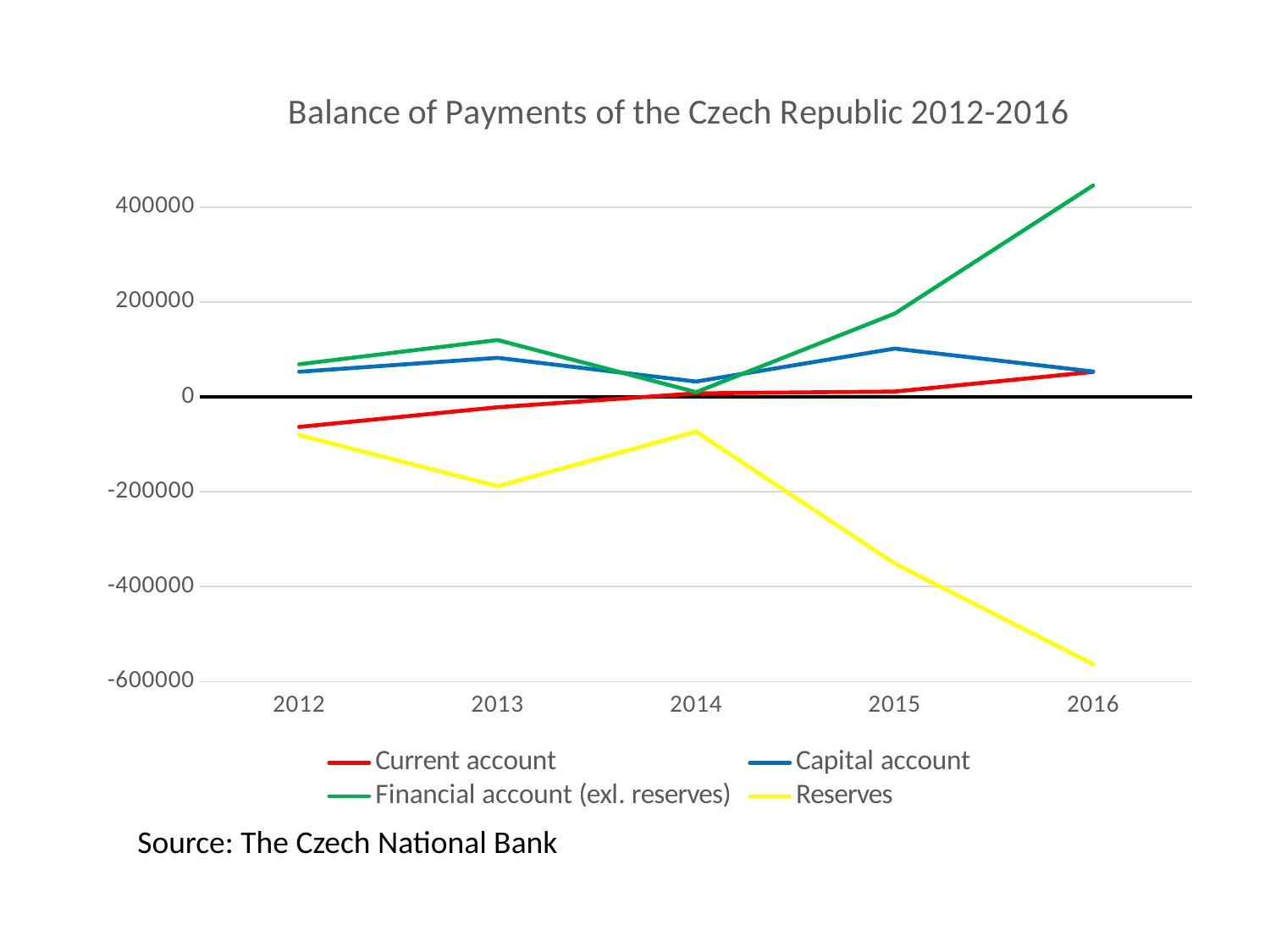
In which year is the Capital account highest? 2015 What kind of chart is shown on the slide? line chart Does the Current account rise or fall from 2012 to 2016? rise What is the title of the chart? Balance of Payments of the Czech Republic 2012-2016 Is the value for Reserves in 2015 greater or less than -200000? less In which year are Reserves lowest? 2016 Is the value for Reserves in 2016 greater or less than -400000? less In 2016, which is larger: the Financial account (exl. reserves) or the Capital account? Financial account (exl. reserves) In which year is the Financial account (exl. reserves) highest? 2016 How many years are plotted along the x axis? 5 Is the value for Financial account (exl. reserves) in 2016 greater or less than 400000? greater How many series does the legend list? 4